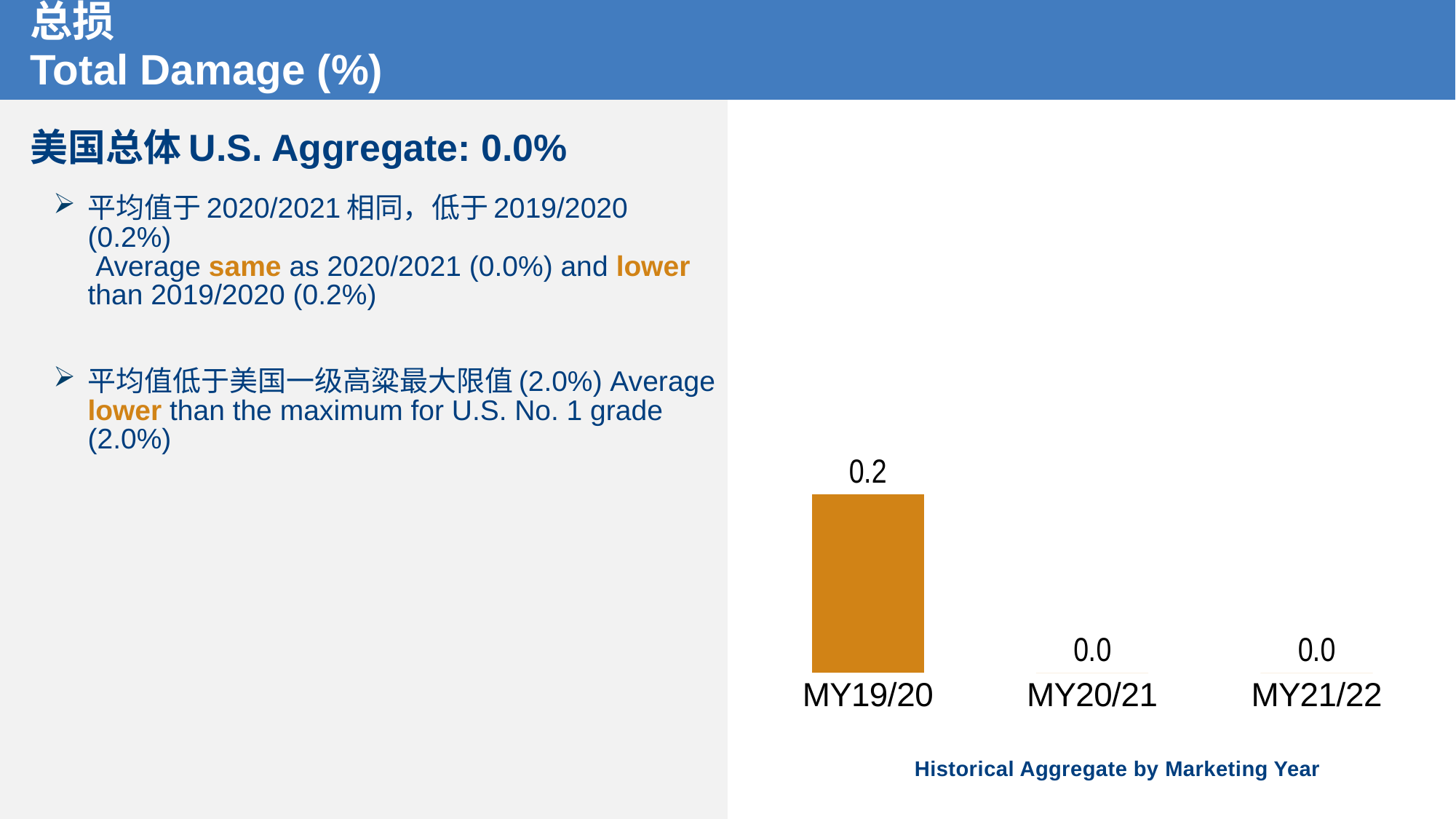
How many marketing years are shown in the chart? 3 What is the value for MY21/22 in the chart? 0.0 Which is larger, the value for MY19/20 or the value for MY21/22? MY19/20 What colour is the bar for MY19/20? Orange What is the caption below the chart? Historical Aggregate by Marketing Year What kind of chart is shown on the slide? Bar chart What is the value for MY20/21 in the chart? 0.0 Which marketing year has the highest value in the chart? MY19/20 What is the value for MY19/20 in the chart? 0.2 Do the values rise or fall from MY19/20 to MY21/22? Fall What is the difference between the values for MY19/20 and MY20/21? 0.2